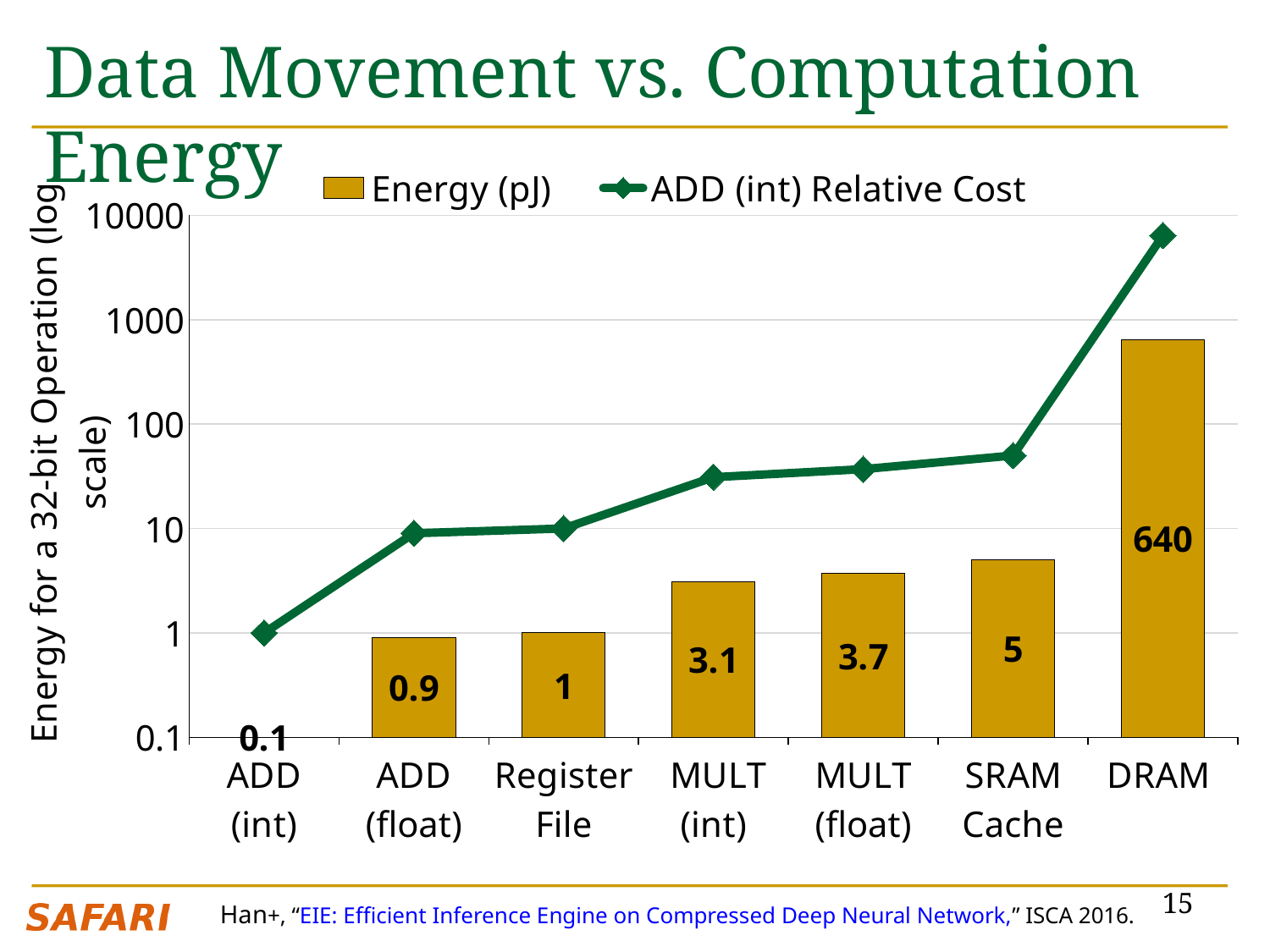
Is the ADD (int) Relative Cost value for SRAM Cache greater or less than 100? less Which category has the lowest Energy (pJ)? ADD (int) Do the Energy (pJ) values rise or fall from ADD (int) to DRAM along the x axis? rise Which category has the highest Energy (pJ)? DRAM What is the Energy (pJ) value for SRAM Cache? 5 What is the Energy (pJ) value for MULT (float)? 3.7 What is the difference in Energy (pJ) between DRAM and SRAM Cache? 635 How many series does the legend list? 2 What is the Energy (pJ) value for DRAM? 640 Which has a higher Energy (pJ) value, MULT (int) or ADD (float)? MULT (int) How many categories are shown on the x axis? 7 Is the ADD (int) Relative Cost value for DRAM greater or less than 1000? greater